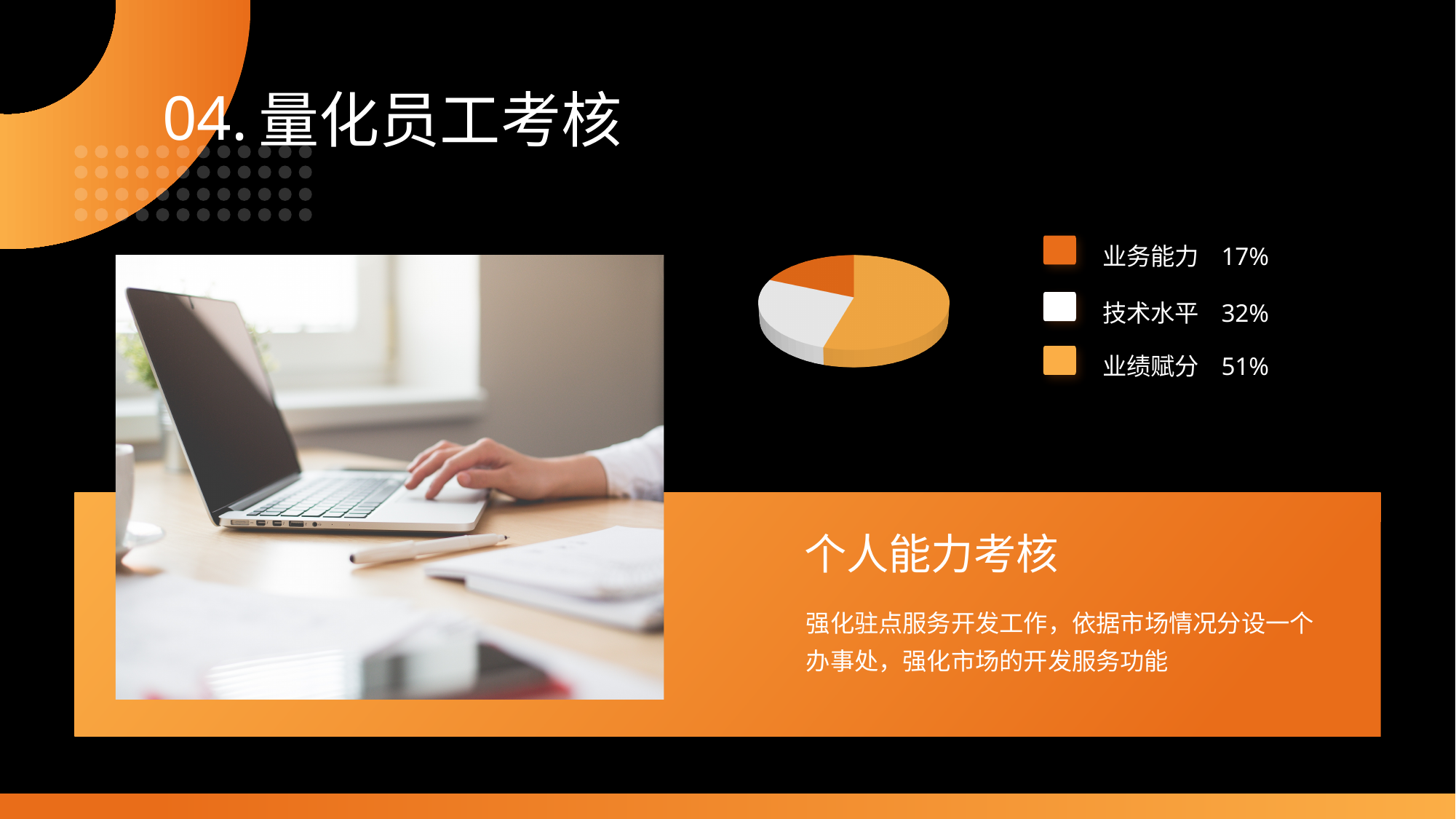
What kind of chart is shown on the slide? pie chart Which is larger in the pie chart, 技术水平 or 业务能力? 技术水平 What is the difference between the shares of 业绩赋分 and 技术水平? 19% Which category has the largest share of the pie chart? 业绩赋分 How many entries does the pie chart's legend list? 3 What colour is the slice for 技术水平 in the pie chart? white What is the value for 业绩赋分 in the pie chart? 51% What is the difference between the shares of 技术水平 and 业务能力? 15% What is the value for 技术水平 in the pie chart? 32% How many slices does the pie chart have? 3 Which category has the smallest share of the pie chart? 业务能力 What is the value for 业务能力 in the pie chart? 17%